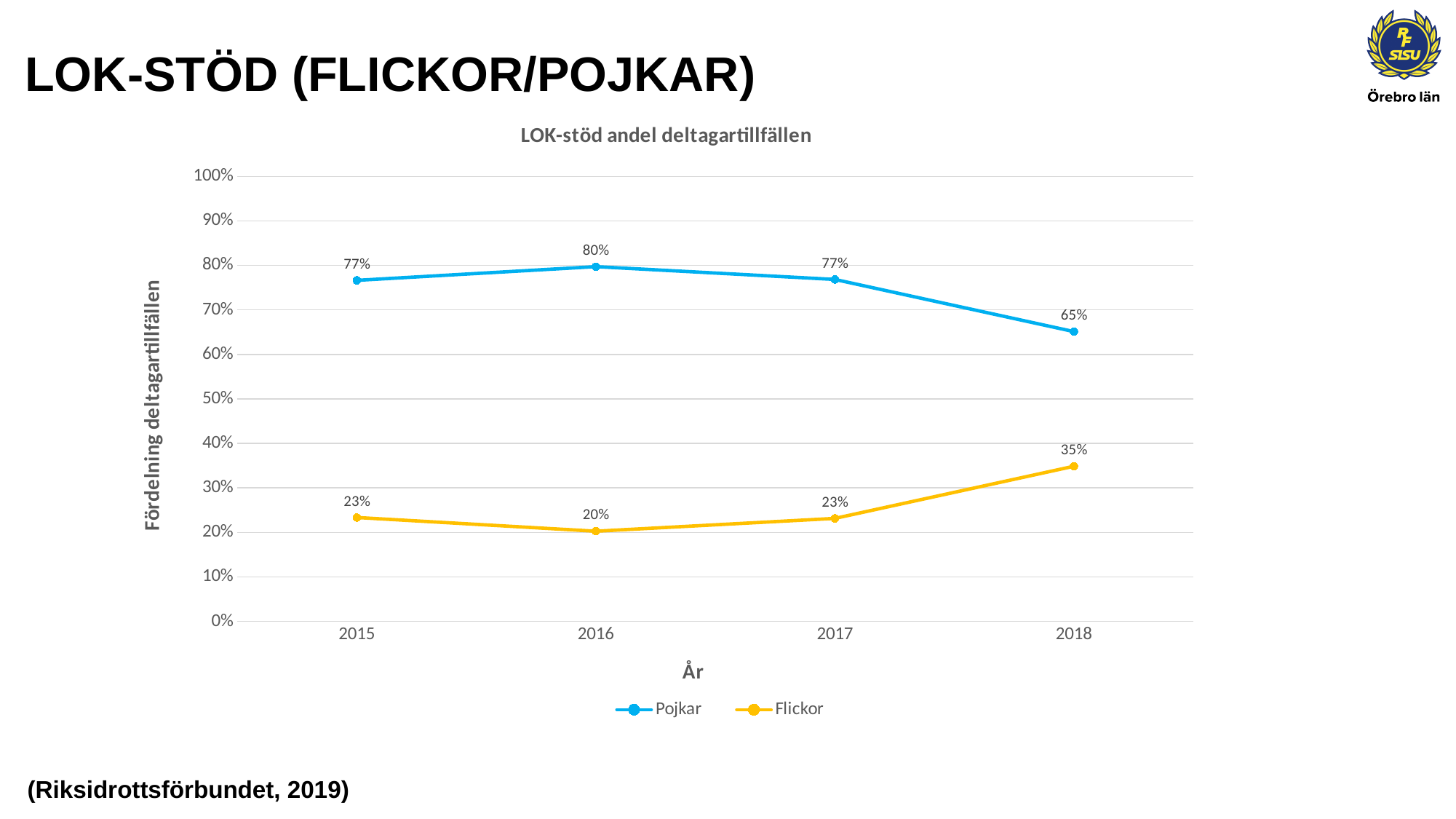
Does the Flickor value rise or fall from 2016 to 2018? rise What is the value for Pojkar in 2016? 80% What kind of chart is shown? line chart How many series does the legend list? 2 What is the difference between the Pojkar and Flickor values in 2018? 30% Which series has the larger value in 2017, Pojkar or Flickor? Pojkar Is the value for Pojkar in 2018 greater or less than 70%? less In which year is the Pojkar value highest? 2016 How many years are shown on the x axis? 4 What is the value for Flickor in 2018? 35% In which year is the Flickor value lowest? 2016 What is the value for Flickor in 2016? 20%